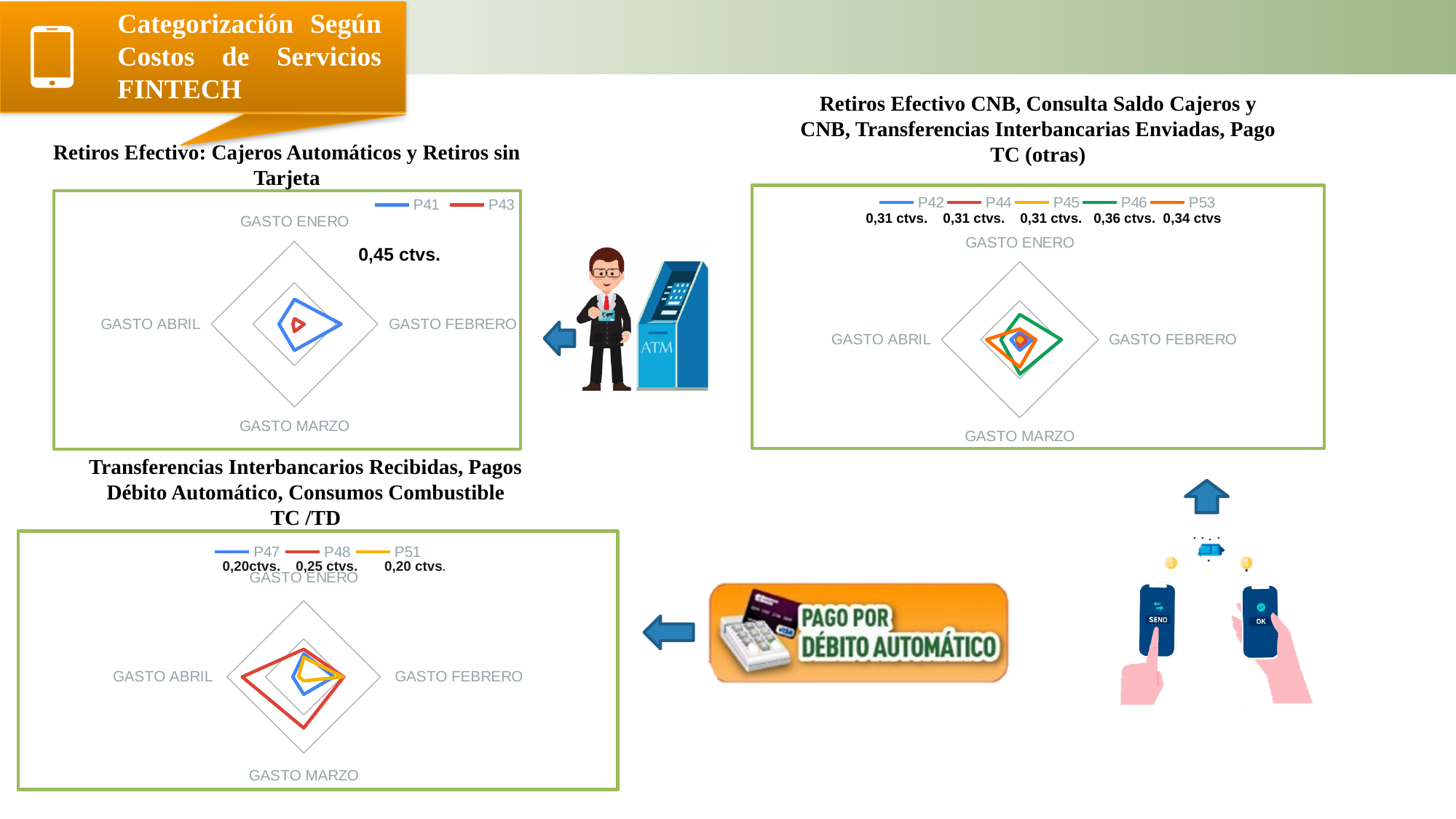
In the top-right chart (Retiros Efectivo CNB, Consulta Saldo Cajeros y CNB, Transferencias Interbancarias Enviadas, Pago TC (otras)), what value is printed for series P53? 0,34 ctvs How many series does the legend list in the bottom-left chart (Transferencias Interbancarios Recibidas, Pagos Débito Automático, Consumos Combustible TC /TD)? 3 How many series does the legend list in the chart titled "Retiros Efectivo: Cajeros Automáticos y Retiros sin Tarjeta"? 2 What kind of chart is the chart titled "Retiros Efectivo: Cajeros Automáticos y Retiros sin Tarjeta"? Radar chart In the chart titled "Retiros Efectivo: Cajeros Automáticos y Retiros sin Tarjeta", which series has the larger value at GASTO FEBRERO, P41 or P43? P41 In the bottom-left chart (Transferencias Interbancarios Recibidas, Pagos Débito Automático, Consumos Combustible TC /TD), which series has the largest value at GASTO MARZO? P48 How many series does the legend list in the top-right chart (Retiros Efectivo CNB, Consulta Saldo Cajeros y CNB, Transferencias Interbancarias Enviadas, Pago TC (otras))? 5 What value is annotated on the chart titled "Retiros Efectivo: Cajeros Automáticos y Retiros sin Tarjeta"? 0,45 ctvs. In the bottom-left chart (Transferencias Interbancarios Recibidas, Pagos Débito Automático, Consumos Combustible TC /TD), what value is printed for series P48? 0,25 ctvs. How many categories (axes) are shown in the top-right chart (Retiros Efectivo CNB, Consulta Saldo Cajeros y CNB, Transferencias Interbancarias Enviadas, Pago TC (otras))? 4 In the top-right chart (Retiros Efectivo CNB, Consulta Saldo Cajeros y CNB, Transferencias Interbancarias Enviadas, Pago TC (otras)), which series has the largest value at GASTO FEBRERO? P46 In the top-right chart (Retiros Efectivo CNB, Consulta Saldo Cajeros y CNB, Transferencias Interbancarias Enviadas, Pago TC (otras)), what value is printed for series P46? 0,36 ctvs.